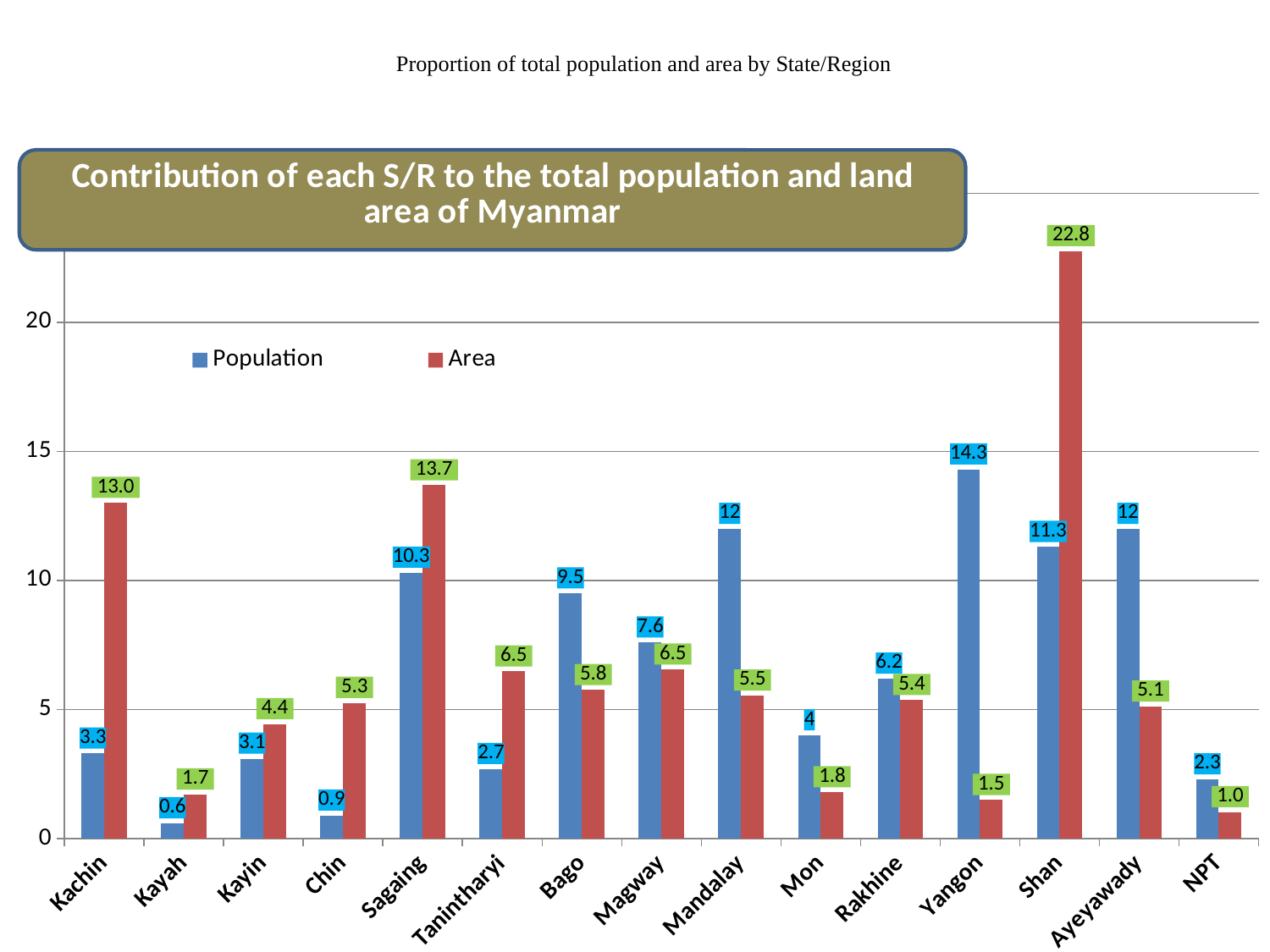
Which State/Region has the highest Population value? Yangon What is the Population value for Sagaing? 10.3 What is the Population value for Yangon? 14.3 How many States/Regions are shown on the x axis? 15 What is the Area value for Shan? 22.8 What is the Area value for Kachin? 13.0 Which State/Region has the lowest Population value? Kayah Which State/Region has the highest Area value? Shan What kind of chart is shown on the slide? Bar chart What is the difference between the Area and Population values for Shan? 11.5 How many series does the legend list? 2 Which is larger for Kachin, the Population value or the Area value? Area